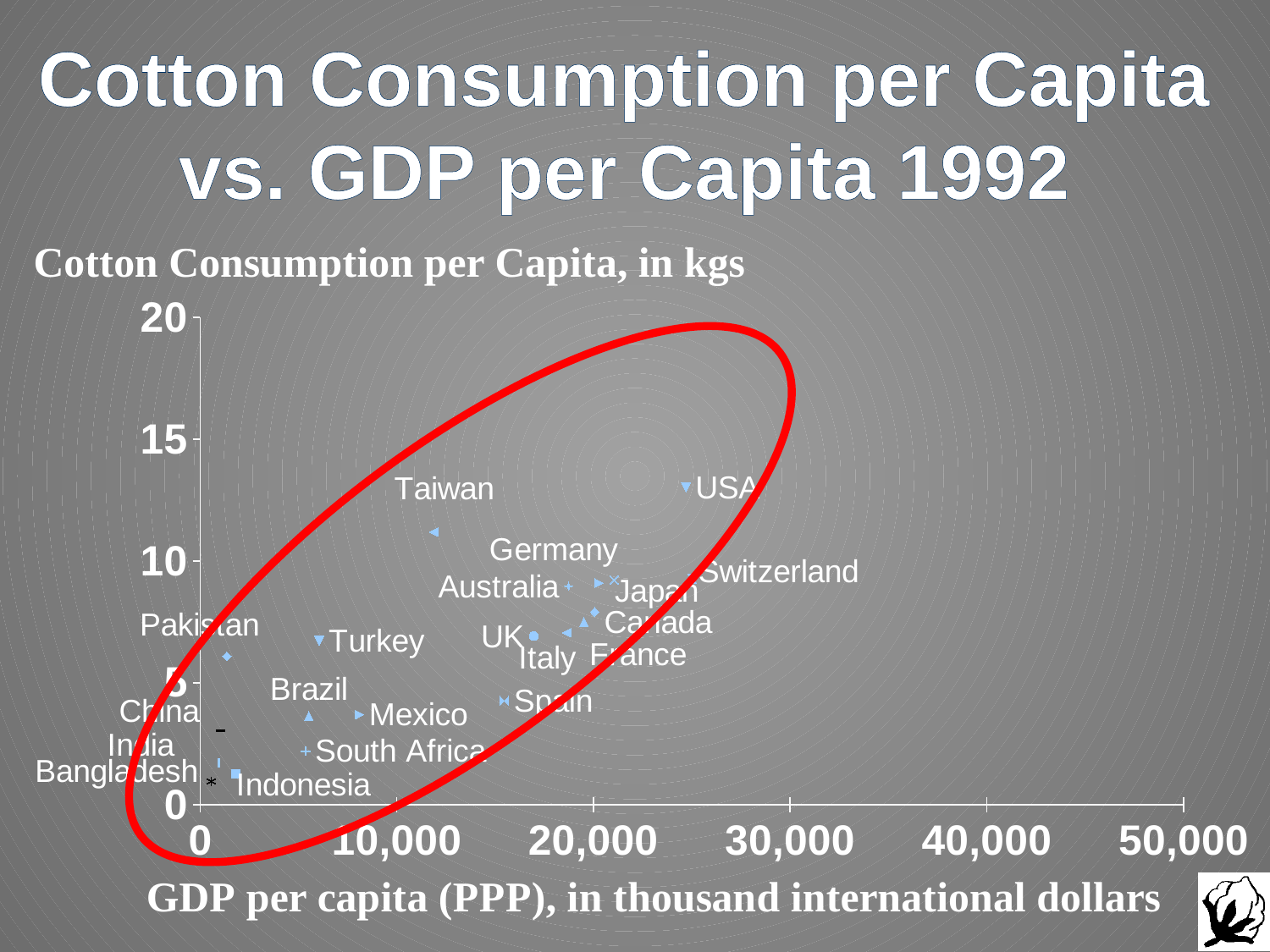
What is the label of the horizontal axis? GDP per capita (PPP), in thousand international dollars Which country has the highest cotton consumption per capita? USA Is the cotton consumption per capita for USA greater or less than 10? greater What is the title of the chart? Cotton Consumption per Capita vs. GDP per Capita 1992 Which has the higher cotton consumption per capita, Taiwan or Turkey? Taiwan How many countries are labelled on the chart? 20 Is the GDP per capita for Bangladesh greater or less than 10,000? less Which has the higher GDP per capita, USA or Pakistan? USA What kind of chart is shown on the slide? scatter chart Which country has the lowest cotton consumption per capita? Bangladesh Is the cotton consumption per capita for Pakistan greater or less than 10? less